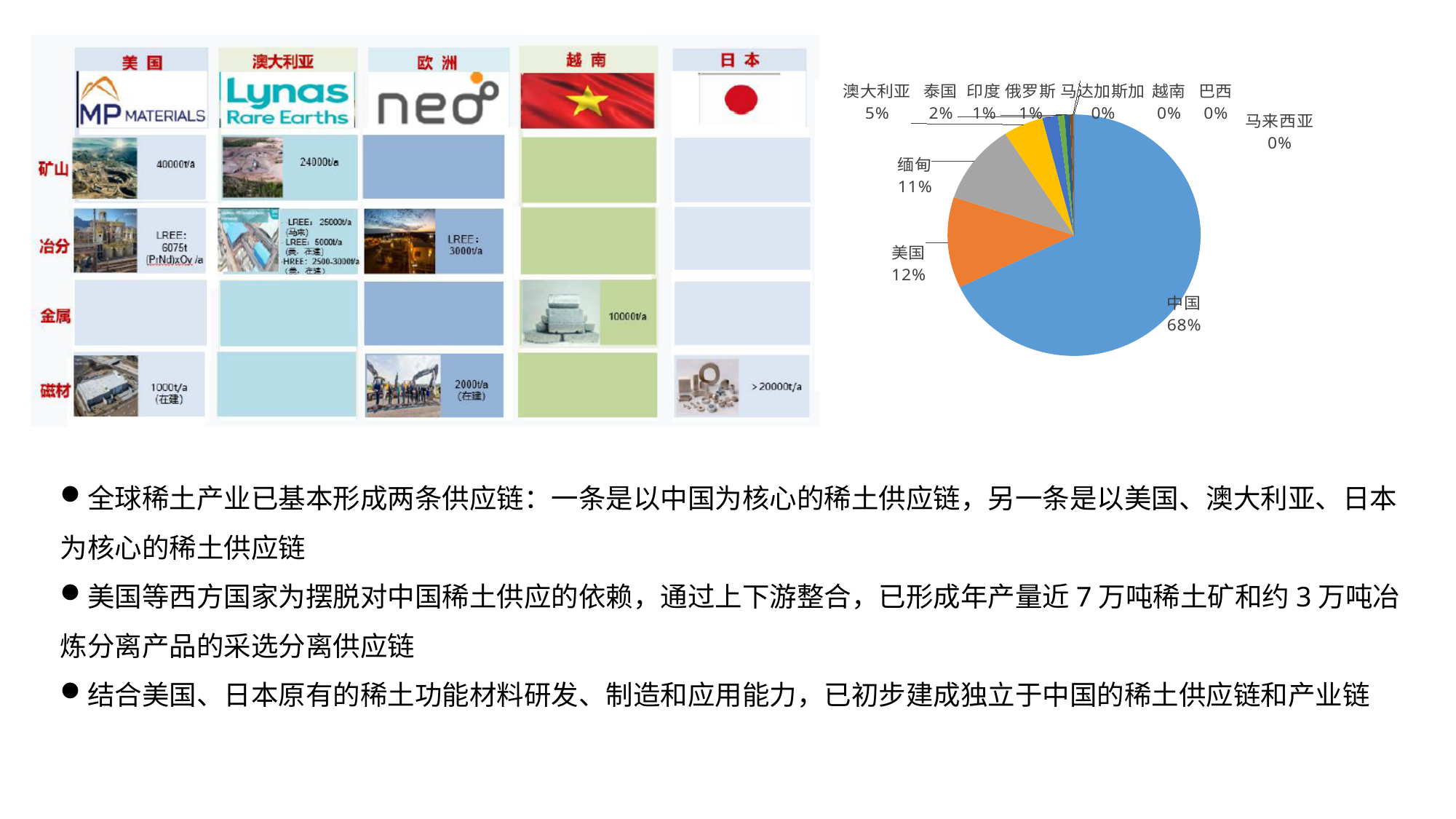
In the pie chart, what share does 缅甸 have? 11% In the pie chart, which has the larger share, 缅甸 or 澳大利亚? 缅甸 In the pie chart, how much larger is the share of 中国 than the share of 美国? 56% In the pie chart, what share is shown for 印度? 1% How many categories are labelled in the pie chart? 11 In the pie chart, what share does 泰国 have? 2% In the pie chart, what is the combined share of 美国 and 缅甸? 23% Which category has the largest slice in the pie chart? 中国 In the pie chart, what share does 中国 have? 68% What kind of chart is shown on the right side of the slide? pie chart In the pie chart, what share does 美国 have? 12% In the pie chart, what share does 澳大利亚 have? 5%